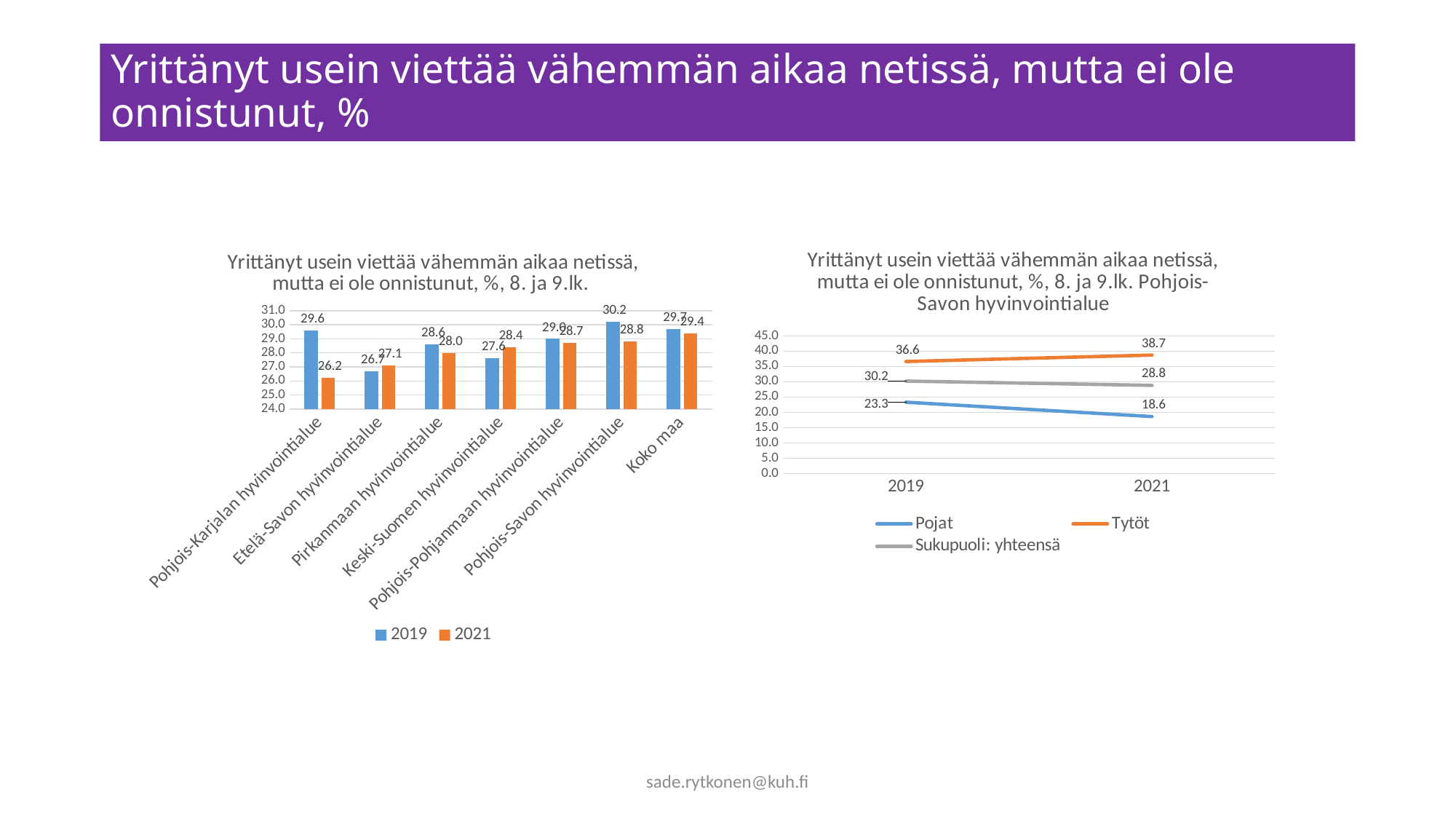
In the left bar chart, which category has the highest 2019 value? Pohjois-Savon hyvinvointialue In the right line chart, what is the difference between the Tytöt and Pojat values in 2019? 13.3 In the left bar chart, what is the difference between the 2019 and 2021 values for Pohjois-Karjalan hyvinvointialue? 3.4 In the left bar chart, what is the 2021 value for Pohjois-Karjalan hyvinvointialue? 26.2 How many categories are shown on the x axis of the left bar chart? 7 In the left bar chart, which category has the lowest 2021 value? Pohjois-Karjalan hyvinvointialue In the left bar chart, is the 2019 value for Etelä-Savon hyvinvointialue or the 2021 value larger? 2021 In the left bar chart, what is the 2019 value for Pohjois-Savon hyvinvointialue? 30.2 How many series does the legend of the left bar chart list? 2 What kind of chart is the chart on the right of the slide? Line chart In the right line chart, does the Pojat line rise or fall from 2019 to 2021? Fall In the right line chart, what is the value for Tytöt in 2021? 38.7